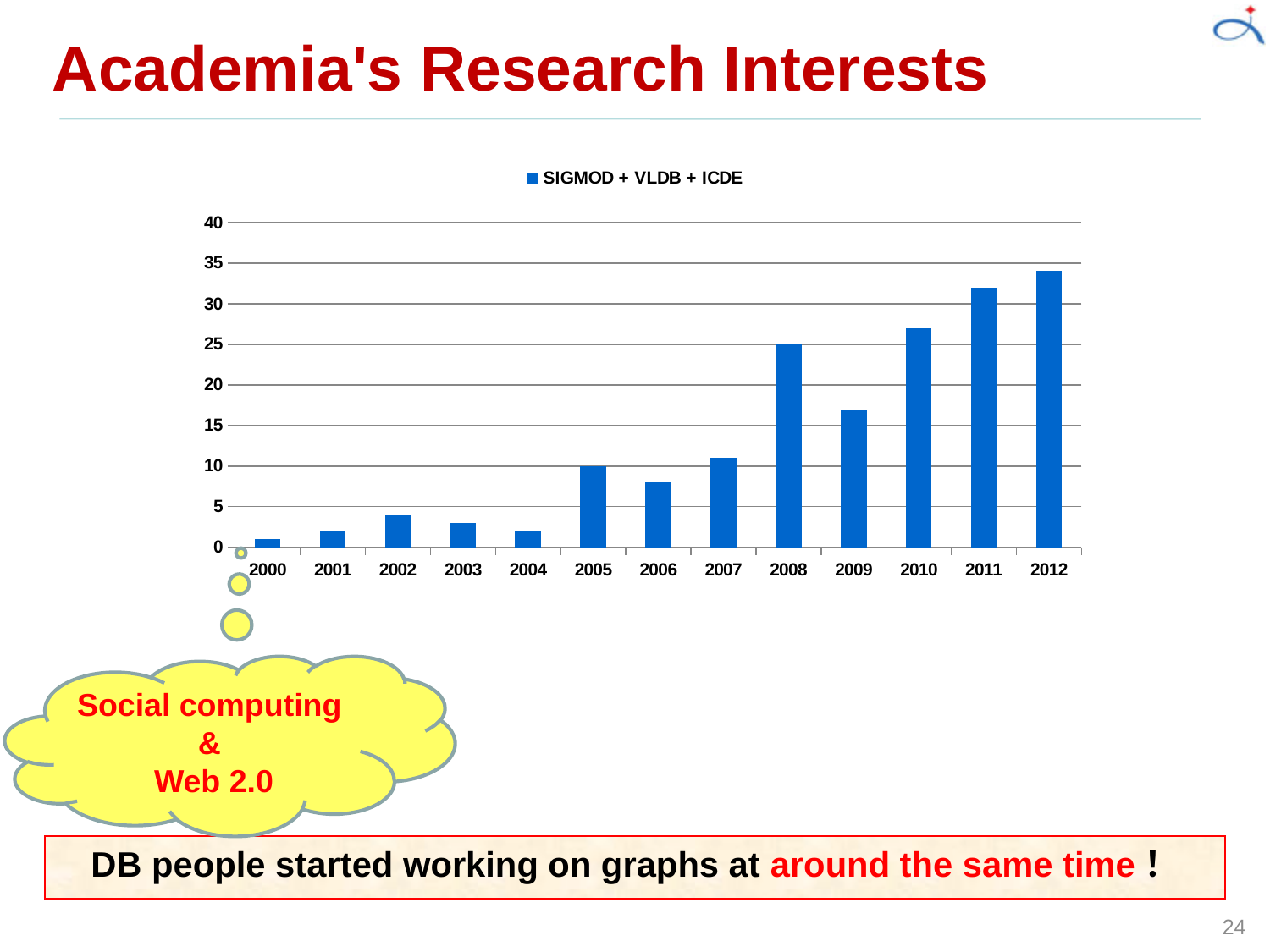
Which is larger, the value for 2008 or the value for 2009? 2008 Is the value for 2006 greater or less than 10? less What is the value for 2008? 25 What kind of chart is shown on the slide? bar chart Which year has the lowest value? 2000 What is the value for 2005? 10 How many years are shown on the x axis? 13 Which year has the highest value? 2012 Is the value for 2011 greater or less than 30? greater What is the name of the series shown in the legend? SIGMOD + VLDB + ICDE How many series does the legend list? 1 Do the values generally rise or fall from 2000 to 2012? rise